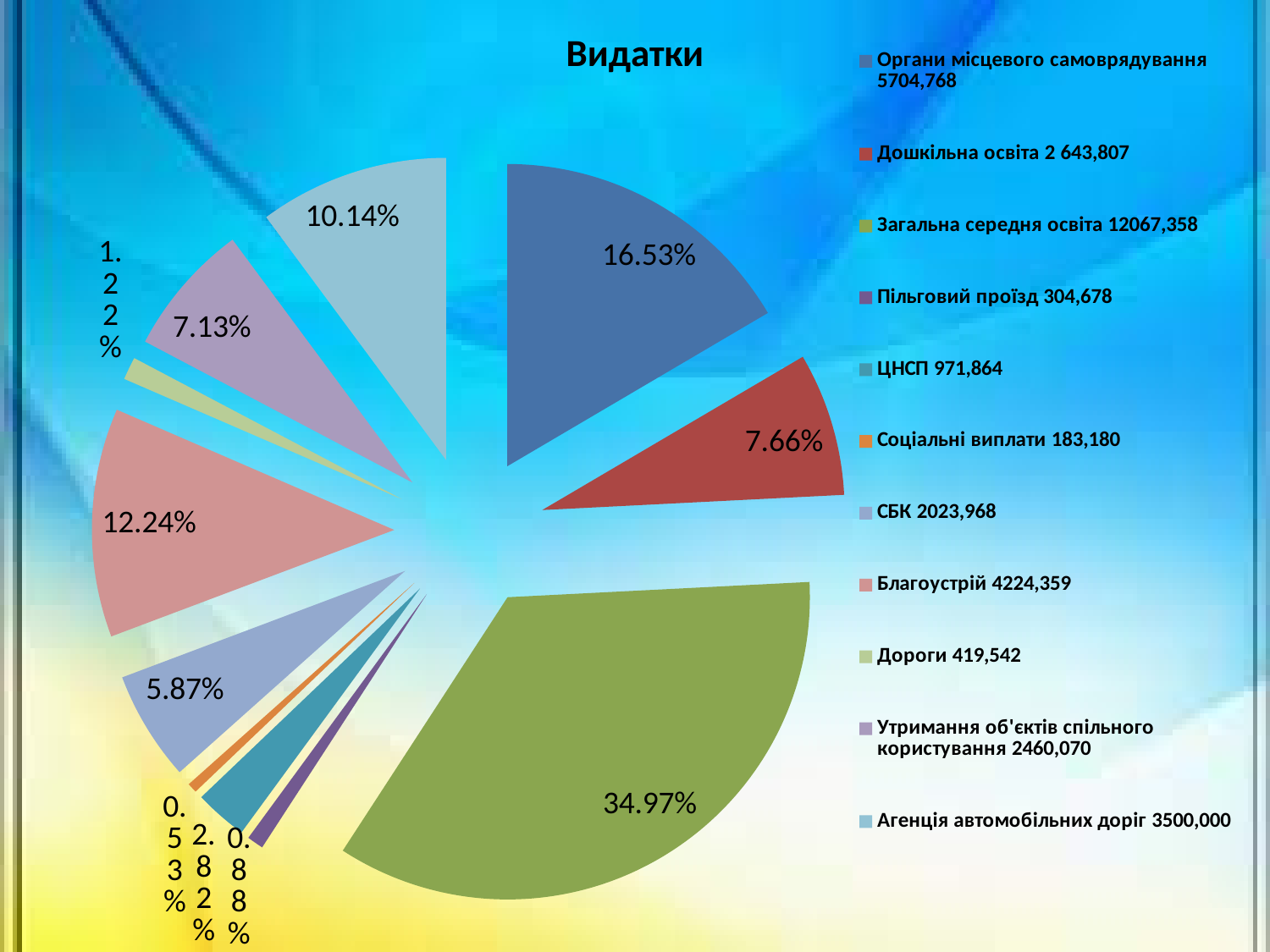
Which category has the smallest slice of the pie? Соціальні виплати What type of chart is shown on the slide? pie chart What share of the pie does Благоустрій take? 12.24% What share of the pie does Агенція автомобільних доріг take? 10.14% What share of the pie does Загальна середня освіта take? 34.97% Which category has the largest slice of the pie? Загальна середня освіта How many categories does the legend of the pie chart list? 11 What is the difference in percentage points between the Органи місцевого самоврядування slice (16.53%) and the Дошкільна освіта slice (7.66%)? 8.87 What is the title of the chart? Видатки What value is shown in the legend for Дошкільна освіта? 2 643,807 Which slice is larger: Благоустрій or СБК? Благоустрій